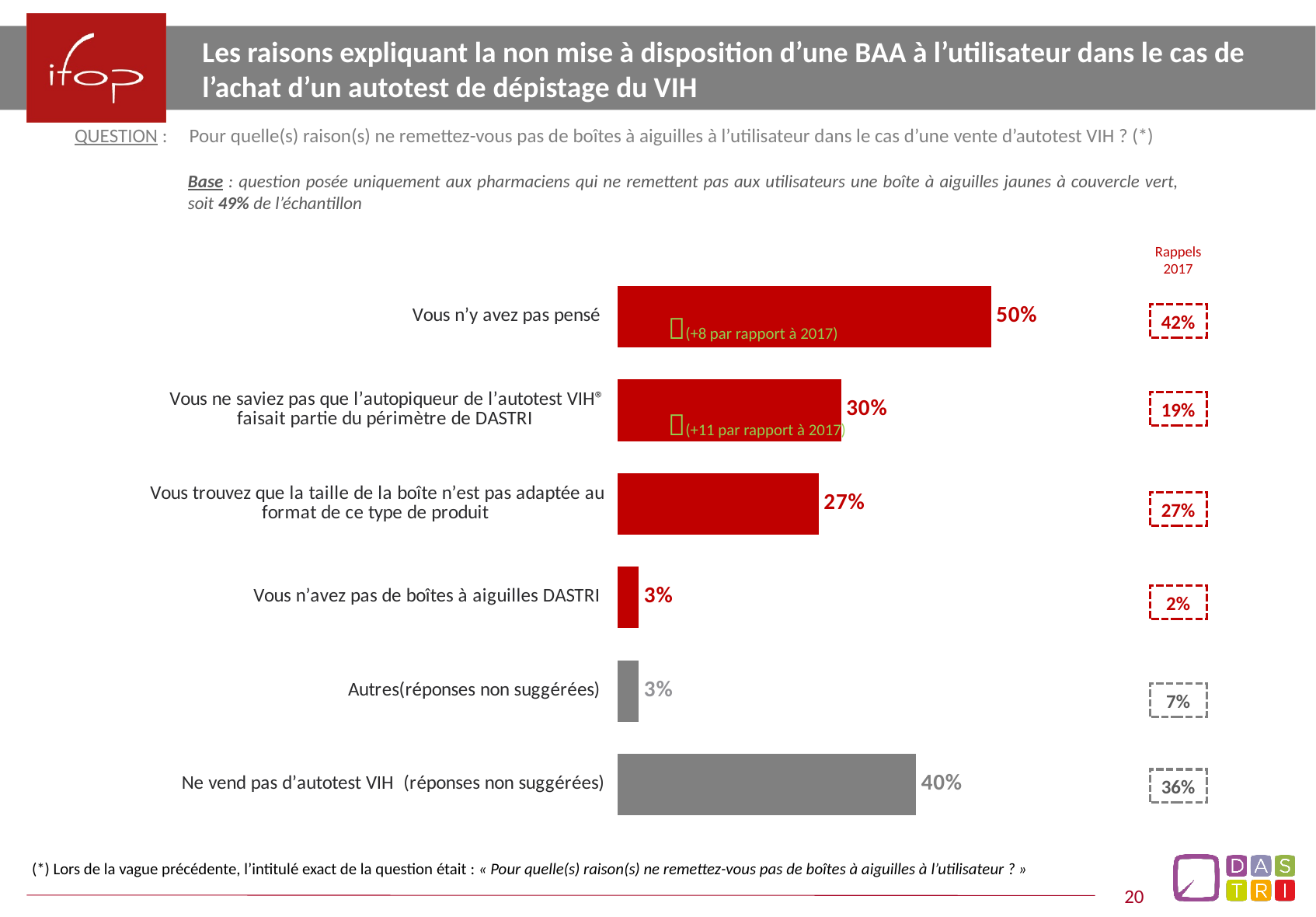
What kind of chart is shown on the slide? Bar chart Which reason has the highest percentage in the chart? Vous n'y avez pas pensé What is the value for "Vous n'avez pas de boîtes à aiguilles DASTRI"? 3% What is the 2017 recall value (Rappels 2017) for "Autres (réponses non suggérées)"? 7% What percentage of respondents answered "Vous n'y avez pas pensé"? 50% How many reasons (categories) are plotted in the chart? 6 What is the difference in percentage points between "Vous n'y avez pas pensé" and "Ne vend pas d'autotest VIH (réponses non suggérées)"? 10 points What is the 2017 recall value (Rappels 2017) for "Vous ne saviez pas que l'autopiqueur de l'autotest VIH faisait partie du périmètre de DASTRI"? 19% Which is larger: the value for "Vous ne saviez pas que l'autopiqueur de l'autotest VIH faisait partie du périmètre de DASTRI" or for "Vous trouvez que la taille de la boîte n'est pas adaptée au format de ce type de produit"? Vous ne saviez pas que l'autopiqueur de l'autotest VIH faisait partie du périmètre de DASTRI By how many percentage points did "Vous n'y avez pas pensé" change compared with 2017? +8 What is the value shown for "Ne vend pas d'autotest VIH (réponses non suggérées)"? 40% What percentage is shown for "Vous trouvez que la taille de la boîte n'est pas adaptée au format de ce type de produit"? 27%